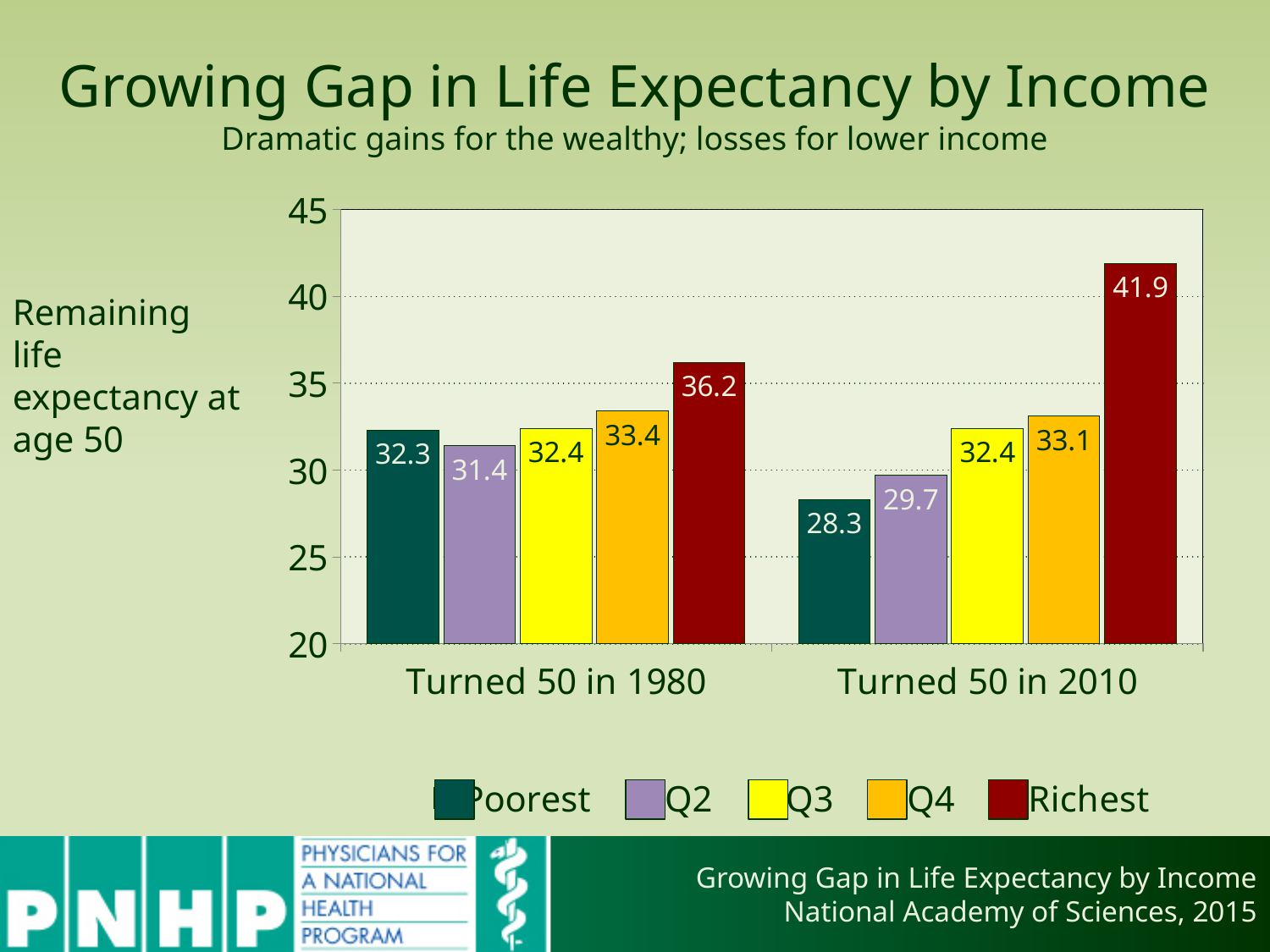
What colour represents the Richest group in the chart? Dark red What is the remaining life expectancy at age 50 for the Poorest group who turned 50 in 1980? 32.3 What is the remaining life expectancy at age 50 for the Richest group who turned 50 in 2010? 41.9 What is the difference between the Richest values for 'Turned 50 in 2010' and 'Turned 50 in 1980'? 5.7 Which income group has the lowest remaining life expectancy among those who turned 50 in 1980? Q2 How many series does the legend list? 5 Is the value for the Richest group who turned 50 in 2010 greater or less than 40? greater Which is larger: the Poorest value for 'Turned 50 in 1980' or the Poorest value for 'Turned 50 in 2010'? Turned 50 in 1980 What kind of chart is shown on the slide? Bar chart Which income group has the highest remaining life expectancy among those who turned 50 in 2010? Richest What is the difference between the Richest and Poorest values for those who turned 50 in 2010? 13.6 What is the value for Q2 in the 'Turned 50 in 2010' group? 29.7